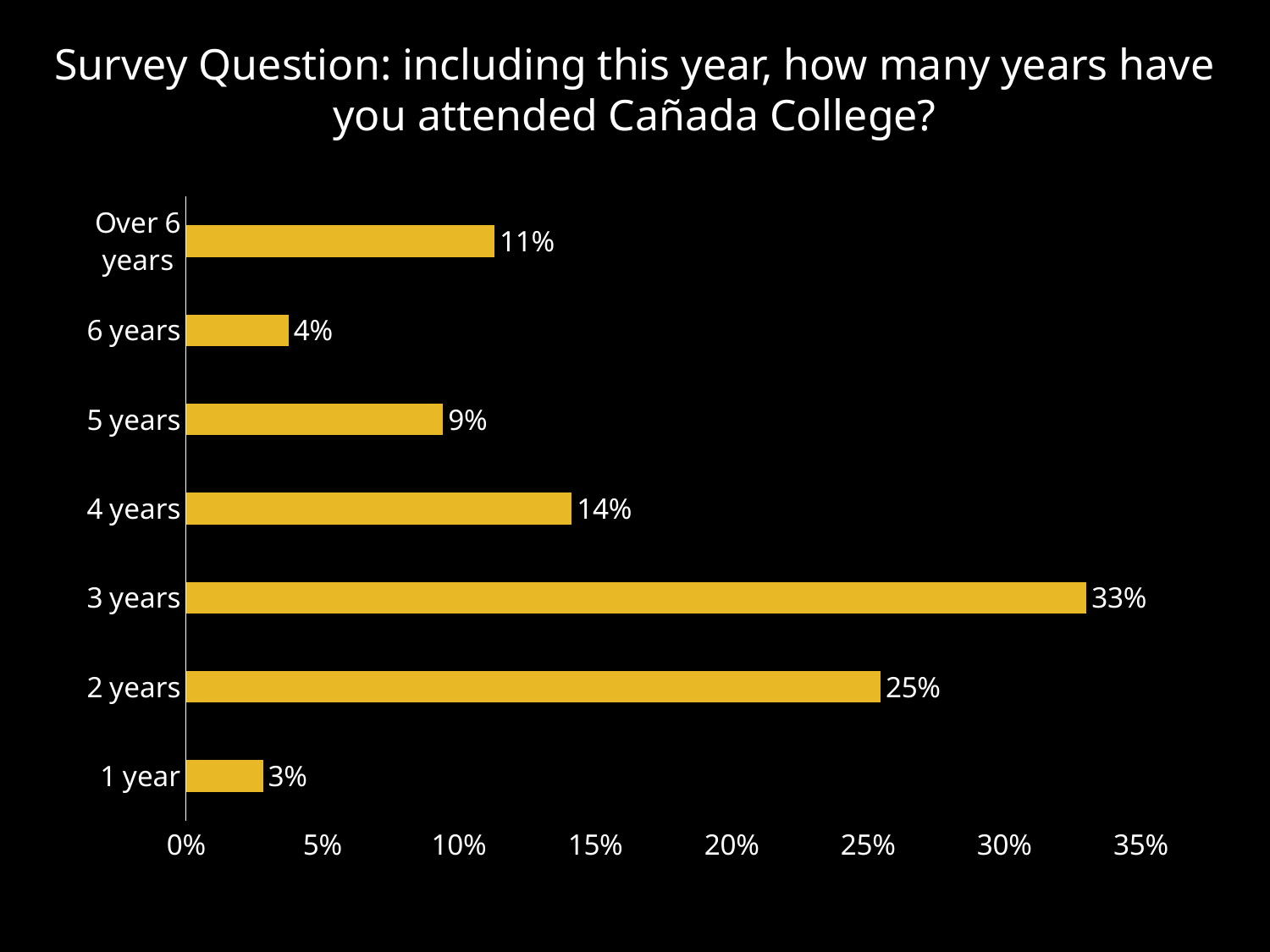
What percentage of respondents have attended for 3 years? 33% What is the difference between the values for 4 years and 5 years? 5% What percentage of respondents have attended for 1 year? 3% What kind of chart is shown on the slide? Bar chart Is the value for 2 years greater or less than 20%? greater What is the value for 'Over 6 years'? 11% What colour are the bars in the chart? Yellow What is the difference between the values for 3 years and 2 years? 8% Which is larger, the value for 5 years or the value for 6 years? 5 years Which category has the highest value? 3 years How many categories are shown on the chart? 7 Which category has the lowest value? 1 year